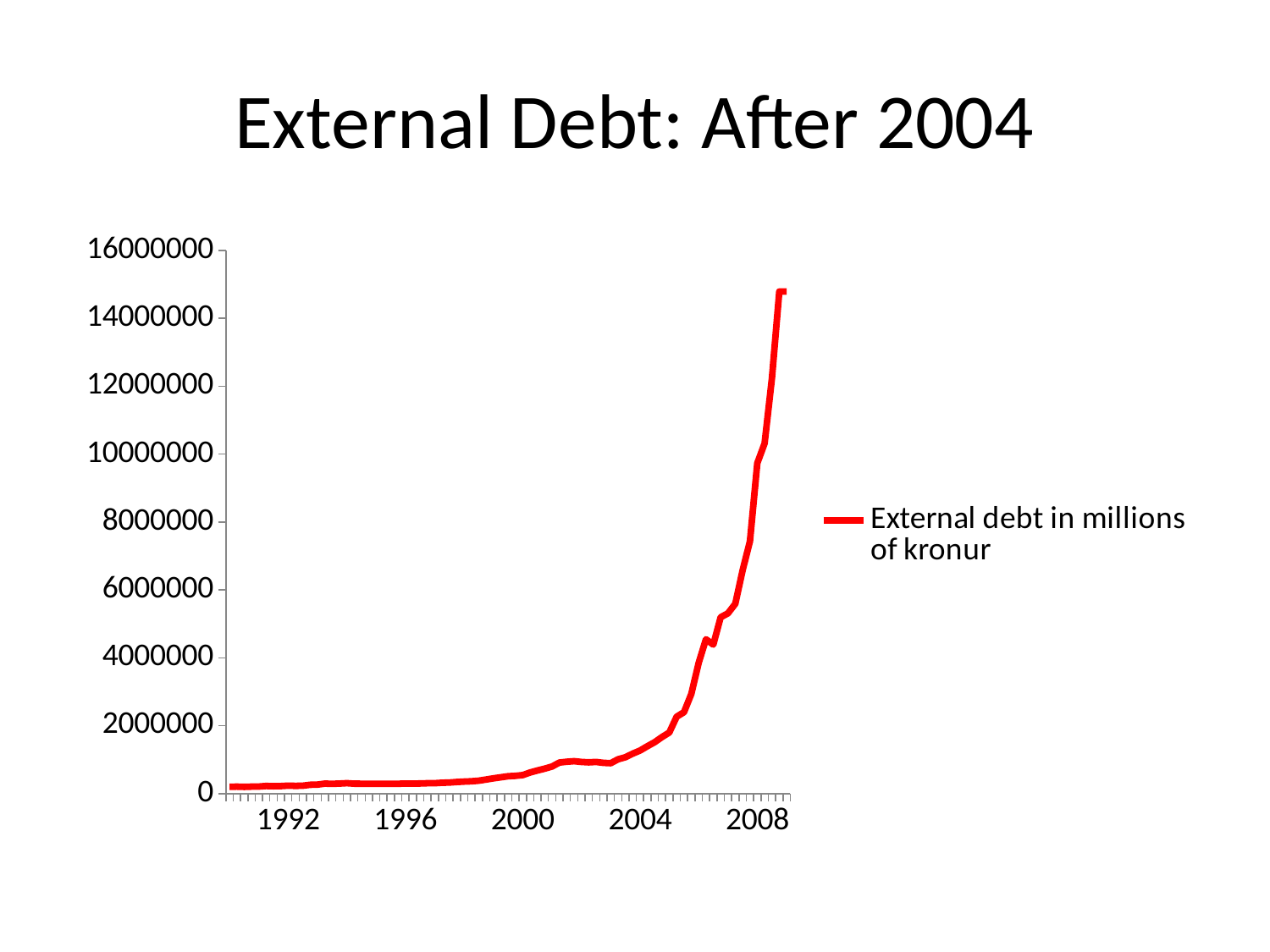
Is the value for 2008 greater or less than 8000000? greater What kind of chart is shown on the slide? line chart Do the values generally rise or fall along the x axis from 1992 to 2008? rise Which is larger, the value for 2008 or the value for 2004? 2008 What is the title of the chart? External Debt: After 2004 Is the highest value on the line greater or less than 14000000? greater Is the value for 2000 greater or less than 2000000? less How many series does the legend list? 1 What series name is shown in the legend? External debt in millions of kronur What is the highest tick value shown on the y axis? 16000000